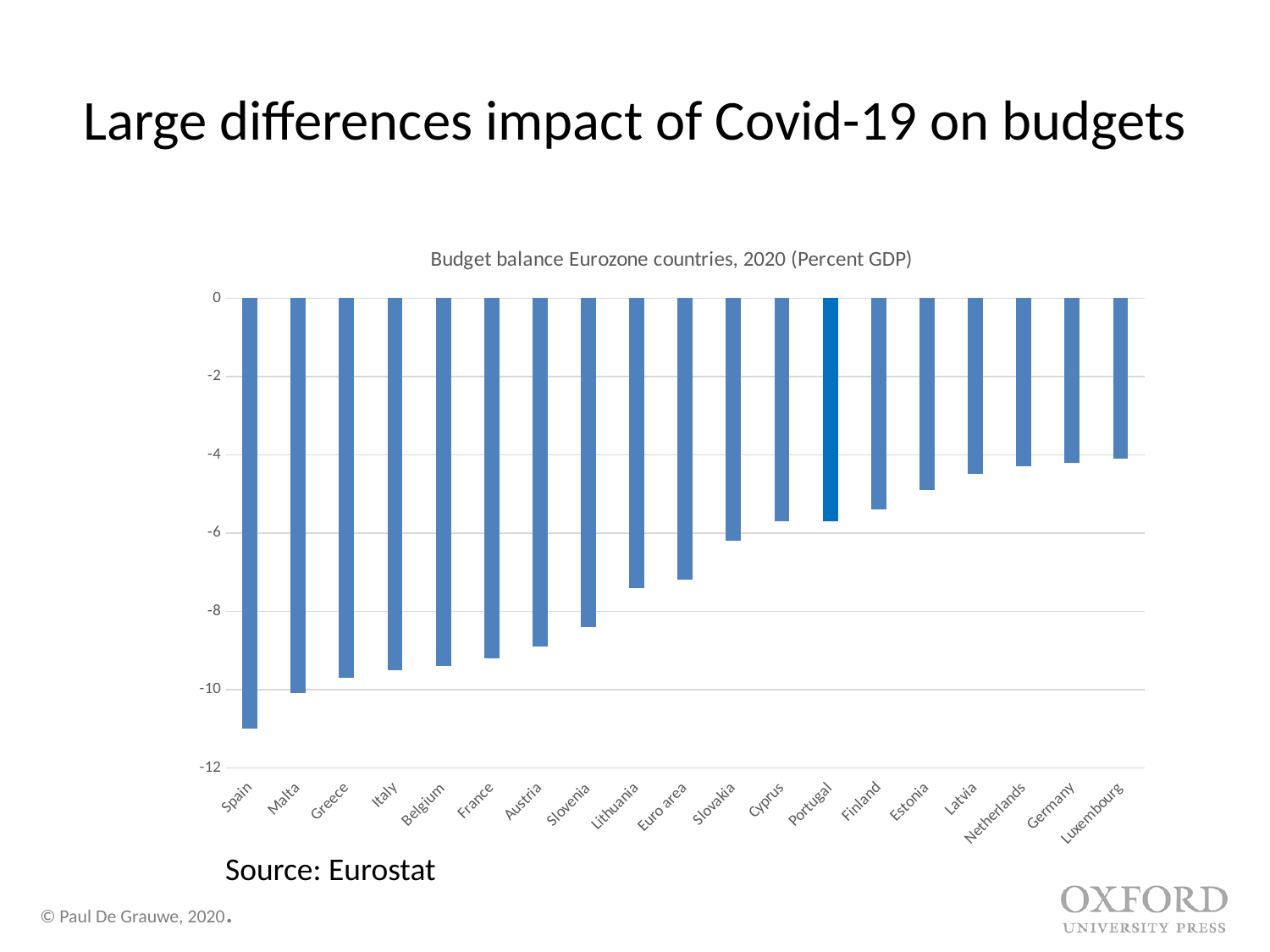
Which country's bar is highlighted in a darker blue than the others? Portugal Is the value for Slovakia greater or less than -8? greater Is the value for Spain greater or less than -10? less Which has the larger (less negative) budget balance, Greece or Finland? Finland Do the values generally rise or fall moving from left to right along the x axis? rise Is the value for Lithuania greater or less than -6? less What kind of chart is shown on the slide? Bar chart What is the title of the chart? Budget balance Eurozone countries, 2020 (Percent GDP) Which country has the lowest (most negative) budget balance in the chart? Spain How many countries or areas are shown on the x axis of the chart? 19